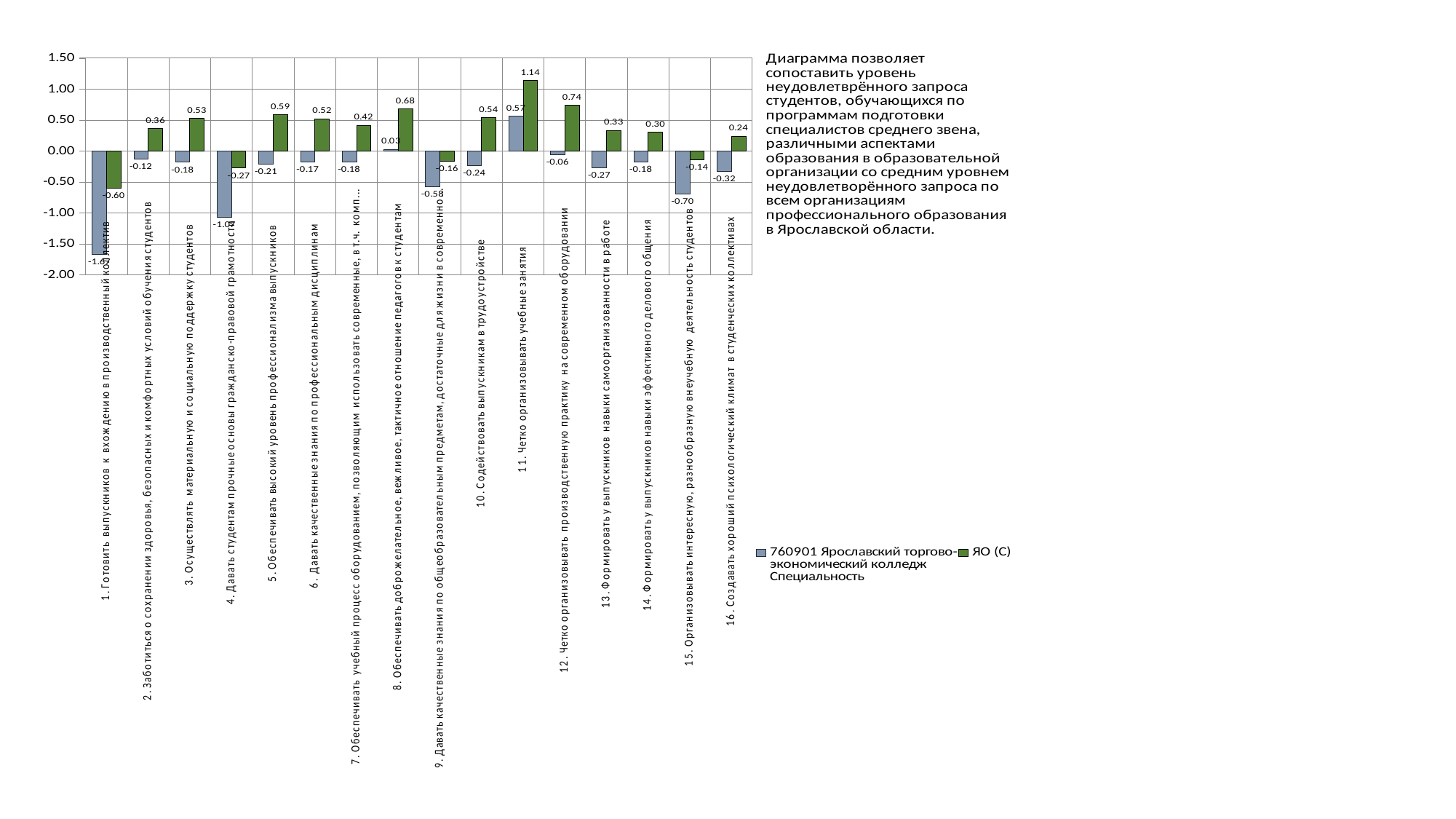
What is the value of the 760901 Ярославский торгово-экономический колледж series for category 11 (Четко организовывать учебные занятия)? 0.57 For category 9 (Давать качественные знания по общеобразовательным предметам), which series has the larger value: ЯО (С) or 760901 Ярославский торгово-экономический колледж? ЯО (С) Is the value of the 760901 Ярославский торгово-экономический колледж series for category 1 (Готовить выпускников к вхождению в производственный коллектив) greater or less than -1.50? less How many categories are plotted on the x axis? 16 What is the value of the ЯО (С) series for category 12 (Четко организовывать производственную практику на современном оборудовании)? 0.74 Which category has the lowest value for the 760901 Ярославский торгово-экономический колледж series? 1. Готовить выпускников к вхождению в производственный коллектив What kind of chart is shown on the slide? bar chart What is the value of the 760901 Ярославский торгово-экономический колледж series for category 15 (Организовывать интересную, разнообразную внеучебную деятельность студентов)? -0.70 What is the difference between the ЯО (С) value and the 760901 Ярославский торгово-экономический колледж value for category 8 (Обеспечивать доброжелательное, вежливое, тактичное отношение педагогов к студентам)? 0.65 What is the value of the ЯО (С) series for category 11 (Четко организовывать учебные занятия)? 1.14 How many series does the legend list? 2 Which category has the highest value for the ЯО (С) series? 11. Четко организовывать учебные занятия